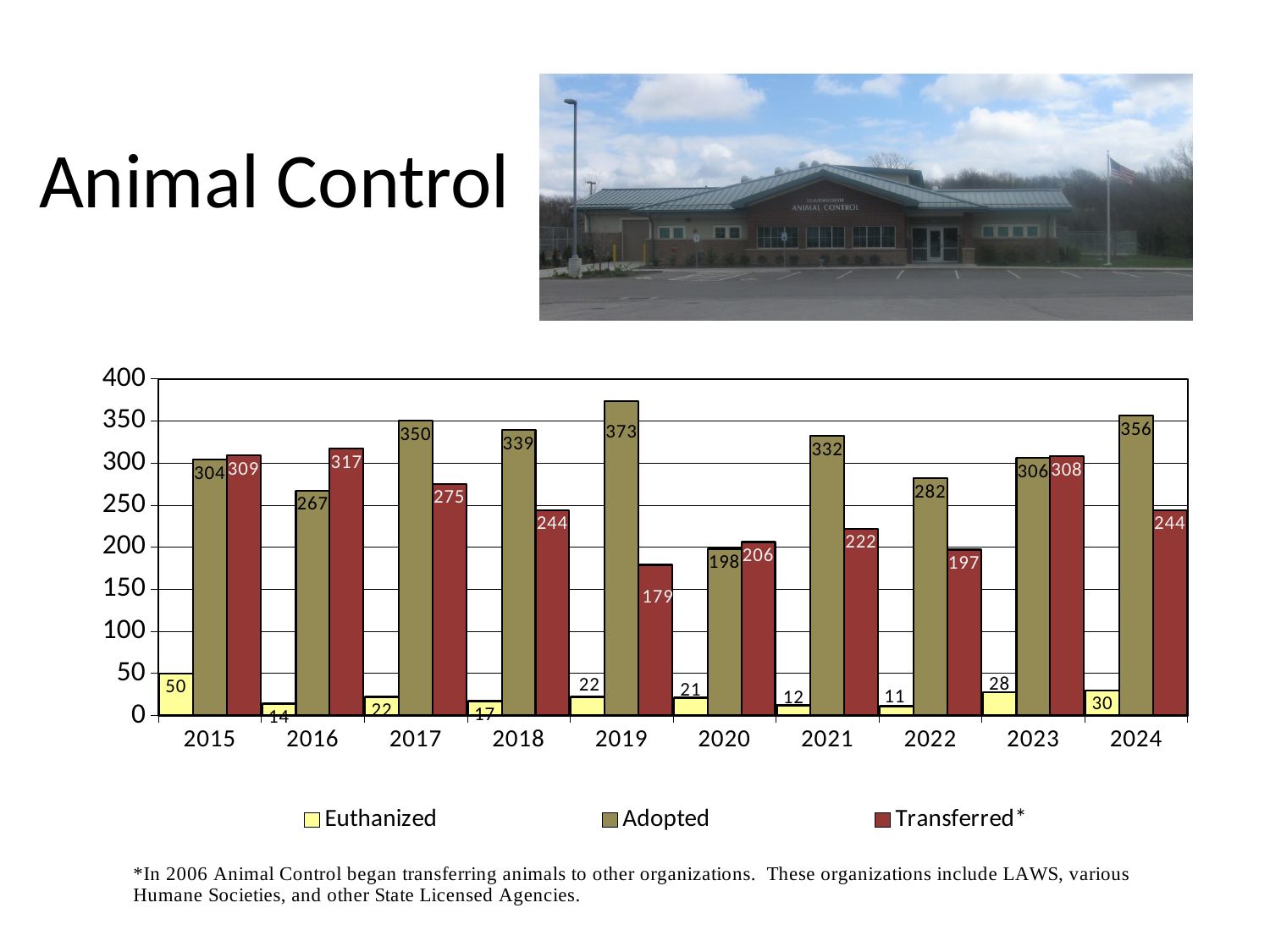
In which year was the Adopted value highest? 2019 What kind of chart is shown on the slide? bar chart What is the difference between the Adopted and Transferred values in 2024? 112 In which year was the Transferred value lowest? 2019 In which year was the Euthanized value lowest? 2022 How many series does the legend list? 3 How many animals were Euthanized in 2015? 50 What is the Transferred value for 2016? 317 In 2015, which is larger: Adopted or Transferred? Transferred How many years are shown on the x axis? 10 What is the Adopted value for 2019? 373 Which legend entry is marked with an asterisk? Transferred*